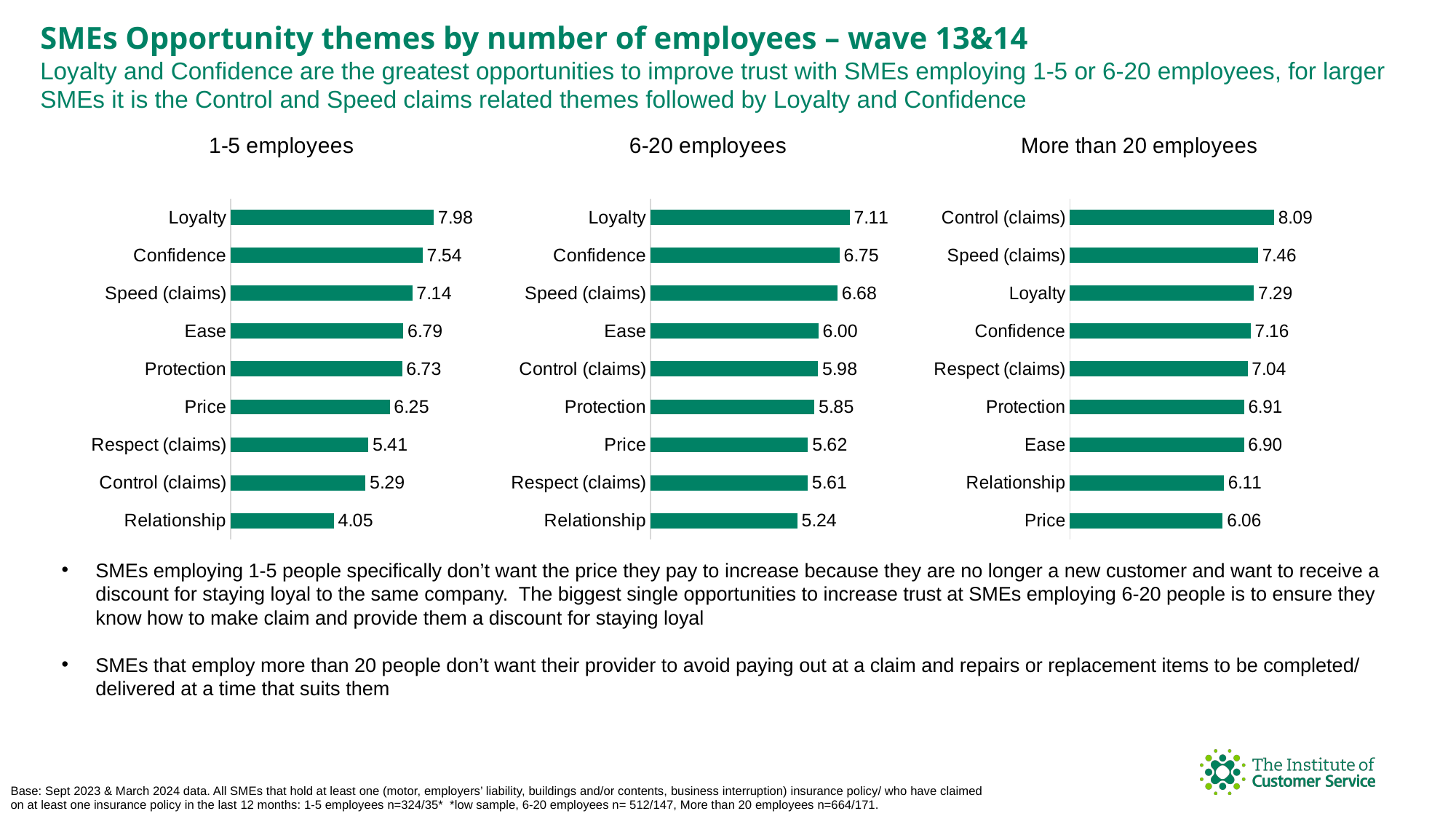
In the 'More than 20 employees' chart, what is the difference between Control (claims) and Speed (claims)? 0.63 How many themes are plotted in the '1-5 employees' chart? 9 In the '6-20 employees' chart, which is larger: Confidence or Price? Confidence In the '6-20 employees' chart, which theme has the lowest value? Relationship In the 'More than 20 employees' chart, what is the value for Respect (claims)? 7.04 How many charts are shown on the slide? 3 In the '1-5 employees' chart, which theme has the lowest value? Relationship In the '6-20 employees' chart, what is the value for Ease? 6.00 In the '1-5 employees' chart, what is the difference between Loyalty and Relationship? 3.93 In the '1-5 employees' chart, what is the value for Loyalty? 7.98 What kind of chart is the '6-20 employees' chart? Bar chart In the 'More than 20 employees' chart, which theme has the highest value? Control (claims)